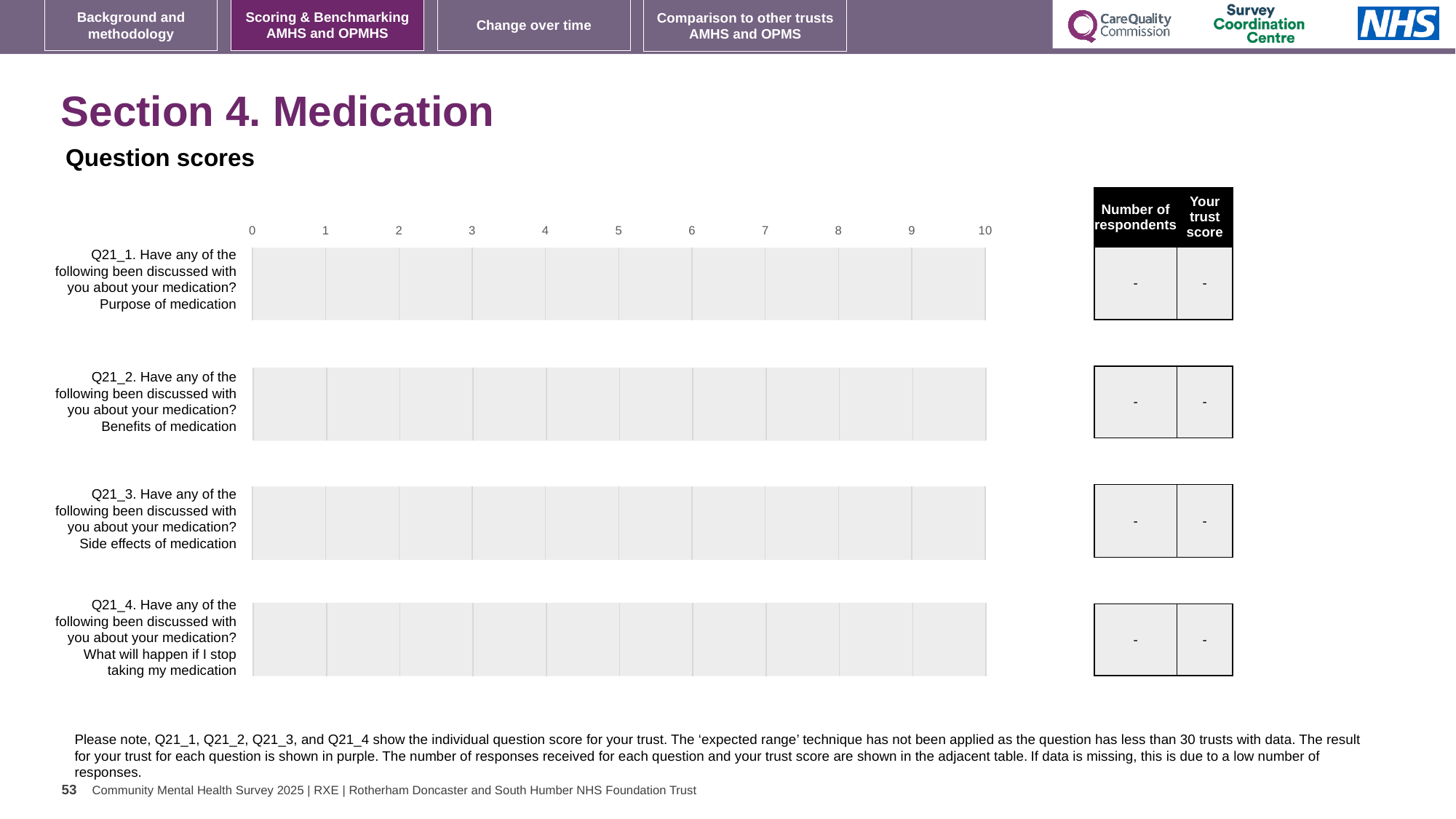
What is the 'Your trust score' shown in the table for Q21_4 (What will happen if I stop taking my medication)? - What is the heading shown above the question scores chart? Question scores What is the 'Your trust score' shown in the table for Q21_1 (Purpose of medication)? - What is the 'Number of respondents' shown in the table for Q21_2 (Benefits of medication)? - What is the maximum value shown on the chart's horizontal axis? 10 What kind of chart is used on the slide for the question scores? bar chart What is the 'Number of respondents' shown in the table for Q21_3 (Side effects of medication)? - How many questions (categories) are listed on the question scores chart? 4